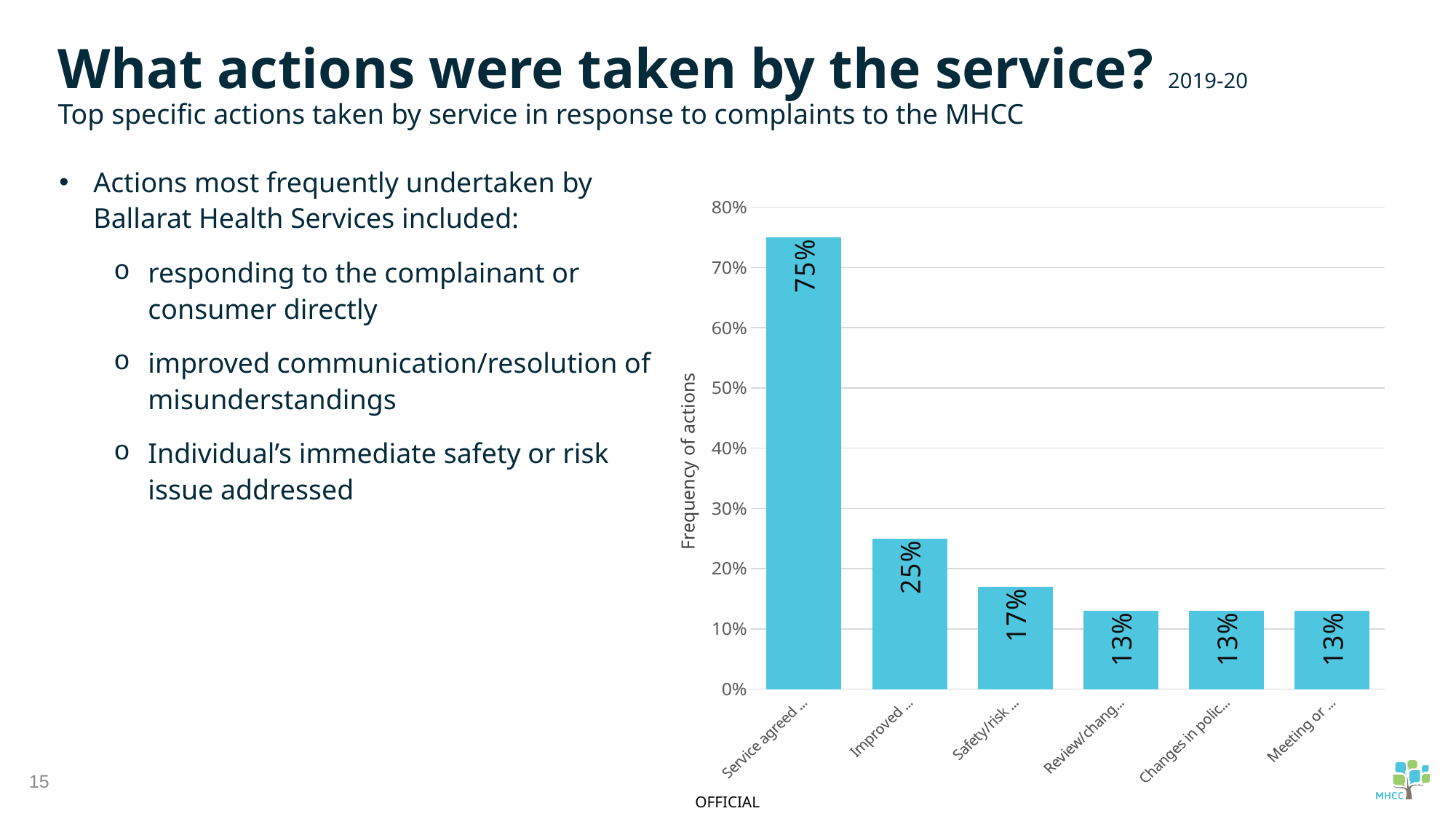
How many bars (categories) are plotted in the chart? 6 Do the bar values rise or fall from left to right across the chart? fall What type of chart is shown on the slide? bar chart What is the value of the bar labelled "Safety/risk ..."? 17% What is the difference between the "Service agreed ..." bar and the "Improved ..." bar? 50 percentage points What is the label of the vertical axis of the chart? Frequency of actions Which category has the highest value in the chart? Service agreed ... What is the difference between the "Improved ..." bar and the "Safety/risk ..." bar? 8 percentage points Which is larger, the value for "Improved ..." or the value for "Safety/risk ..."? Improved ... What is the value of the first bar, labelled "Service agreed ..."? 75% What is the value of the bar labelled "Improved ..."? 25% What is the value of the bar labelled "Changes in polic..."? 13%